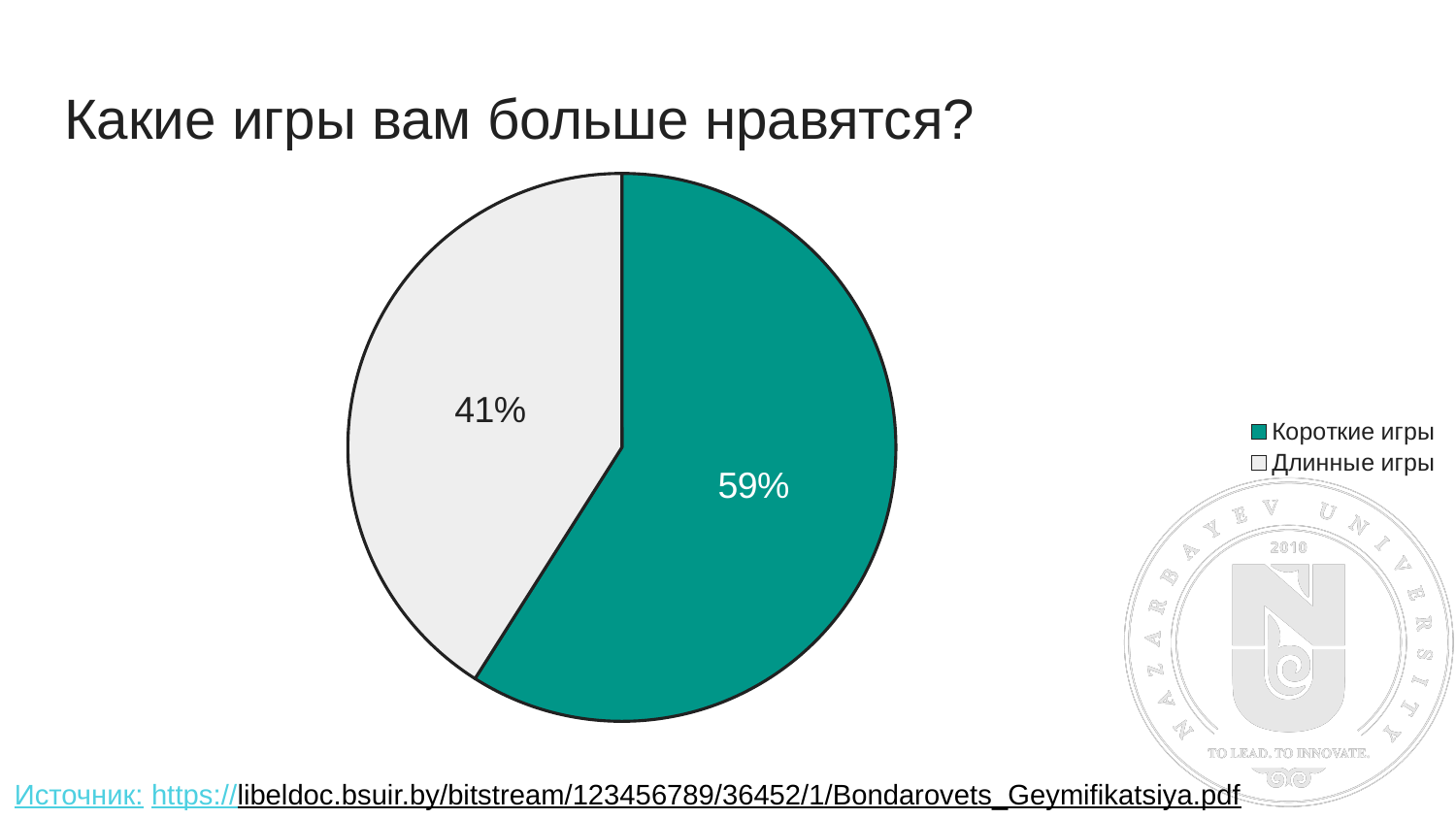
What share of the pie is labelled "Длинные игры"? 41% What colour is the slice for "Короткие игры"? teal (green) What kind of chart is shown on the slide? pie chart What is the title of the slide above the chart? Какие игры вам больше нравятся? How many slices does the pie chart have? 2 Which is larger, the slice for "Короткие игры" or the slice for "Длинные игры"? Короткие игры What share of the pie is labelled "Короткие игры"? 59% What is the difference in percentage points between the "Короткие игры" and "Длинные игры" slices? 18 Which category has the largest slice of the pie? Короткие игры Is the share for "Длинные игры" greater or less than 50%? less How many entries does the legend list? 2 Which category has the smallest slice of the pie? Длинные игры